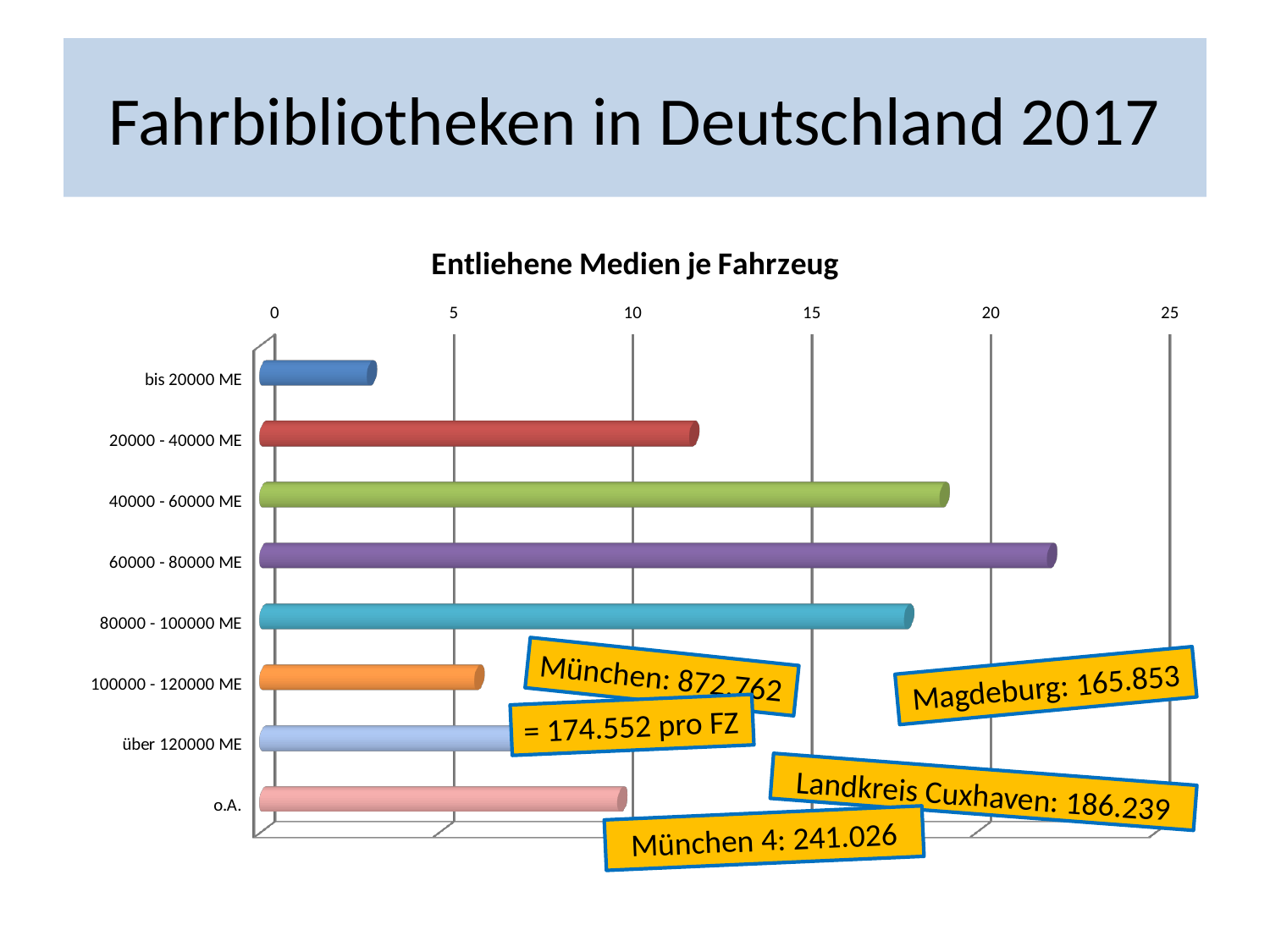
Which is larger, the value for '60000 - 80000 ME' or the value for '40000 - 60000 ME'? 60000 - 80000 ME Which category has the lowest value? bis 20000 ME What kind of chart is shown on the slide? bar chart Is the value for '100000 - 120000 ME' greater or less than 10? less Which category has the highest value? 60000 - 80000 ME Which is larger, the value for '20000 - 40000 ME' or the value for 'o.A.'? 20000 - 40000 ME Is the value for '60000 - 80000 ME' greater or less than 20? greater How many categories are plotted in the chart? 8 Is the value for 'bis 20000 ME' greater or less than 5? less What is the title of the chart? Entliehene Medien je Fahrzeug